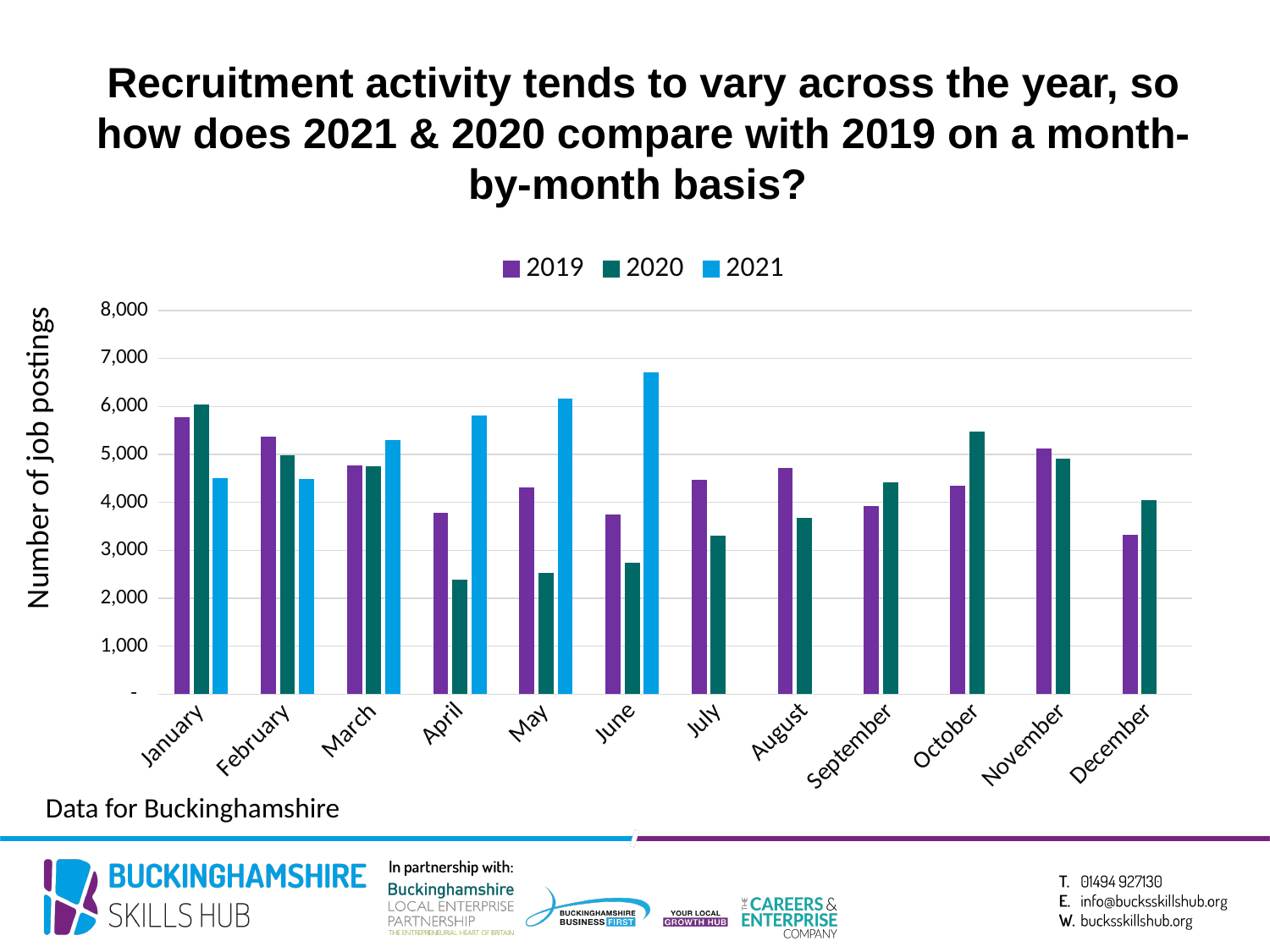
In October, which year has the larger number of job postings, 2019 or 2020? 2020 What kind of chart is shown on the slide? bar chart In which month is the 2021 value highest? June Do the 2021 values rise or fall from February to June? rise In which month is the 2019 value highest? January In which month is the 2020 value lowest? April How many months are shown along the x axis? 12 Is the 2020 value for April greater or less than 3,000? less How many series does the legend list? 3 In which month is the 2019 value lowest? December Is the 2021 value for June greater or less than 6,000? greater In April, which year has the larger number of job postings, 2020 or 2021? 2021